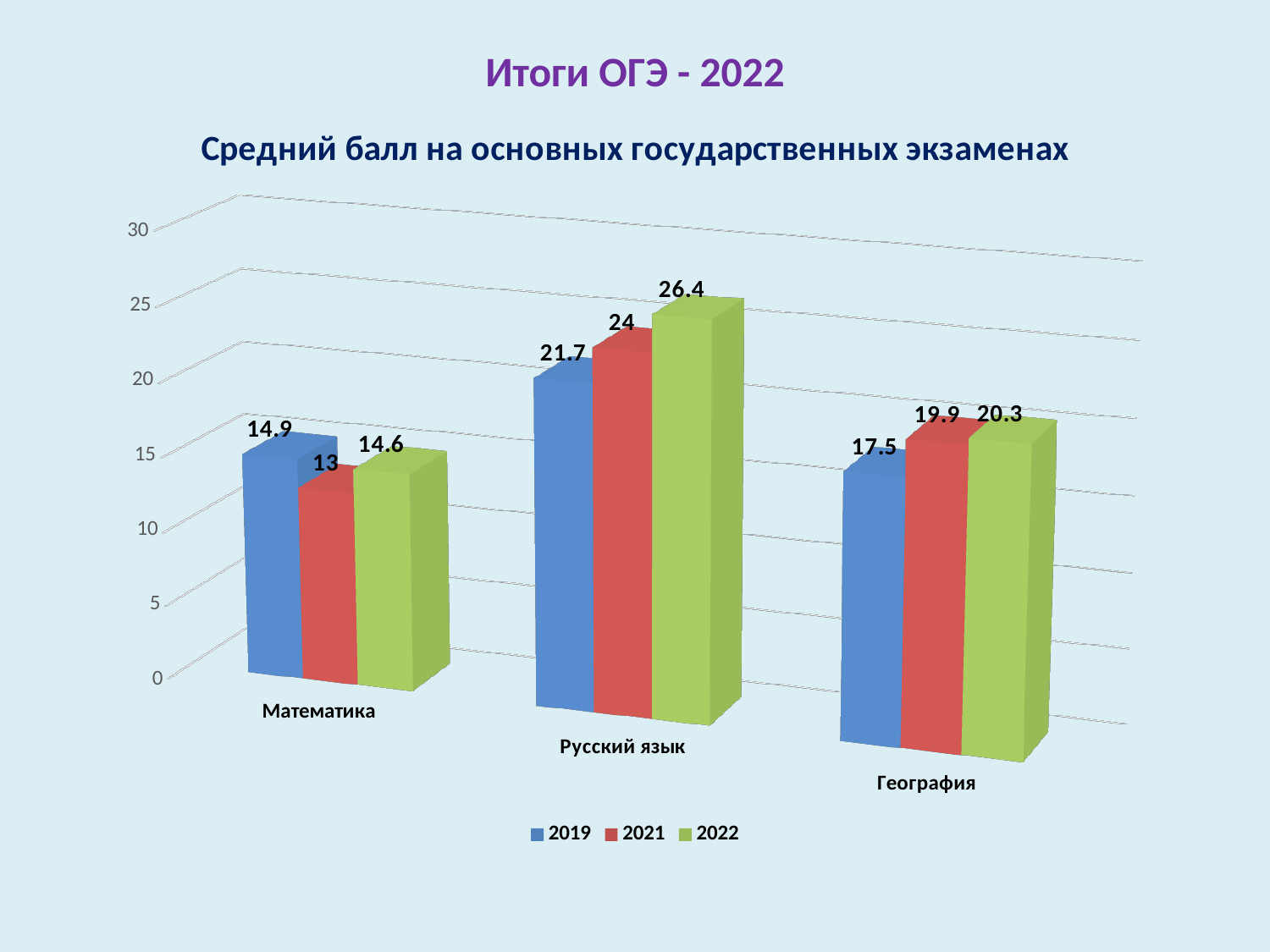
Which subject has the highest average score in 2022? Русский язык What is the difference between the 2019 and 2021 average scores for Математика? 1.9 How many subjects are shown on the chart? 3 How many series does the legend list? 3 What is the average score for Математика in 2021? 13 Which subject has the lowest average score in 2019? Математика What is the difference between the 2022 and 2019 average scores for Русский язык? 4.7 Which is larger: the 2021 score for География or the 2021 score for Математика? География What kind of chart is shown on the slide? Bar chart What is the average score for Русский язык in 2022? 26.4 What is the title of the chart? Средний балл на основных государственных экзаменах What is the average score for География in 2019? 17.5